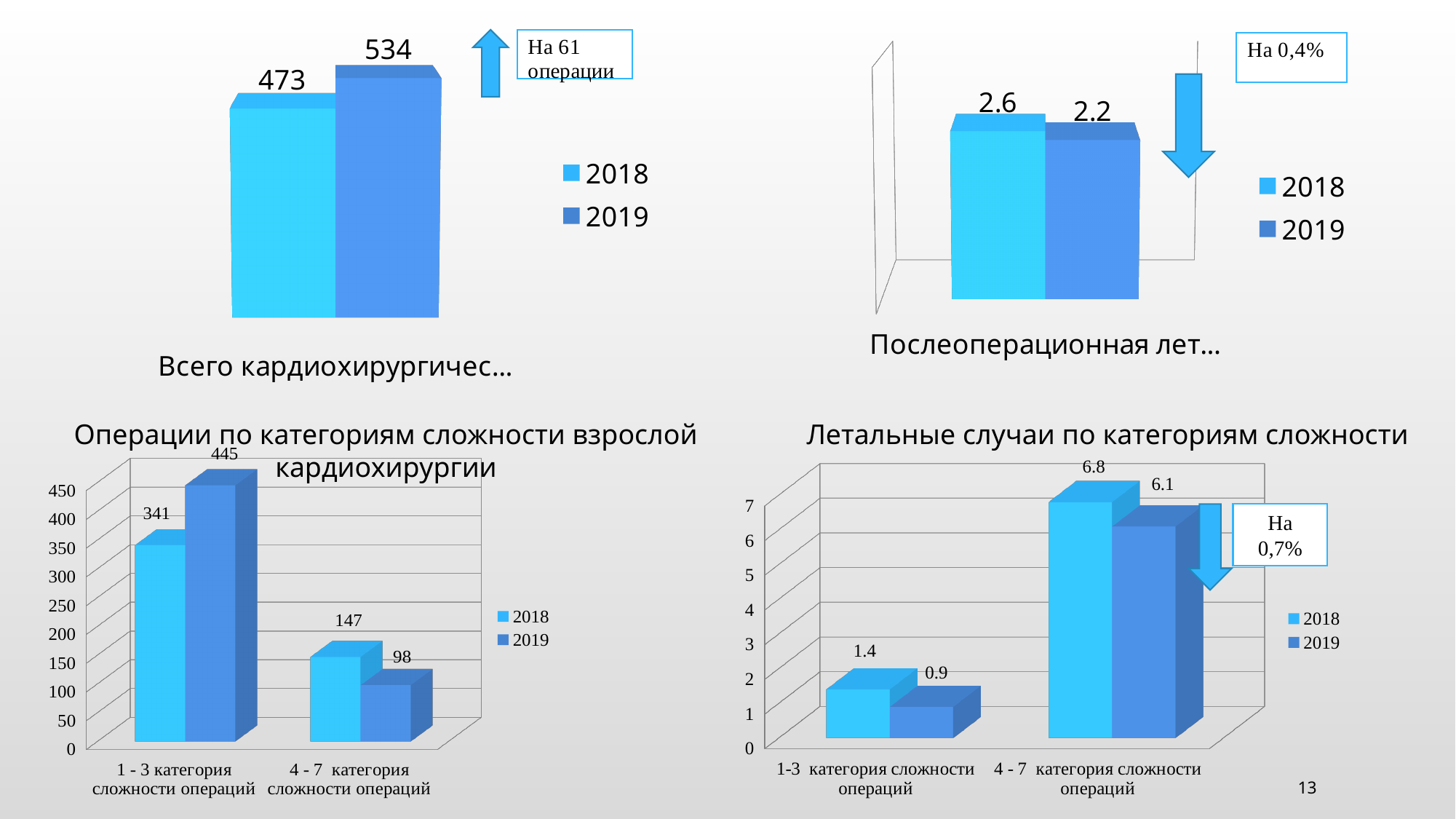
In the bottom-left chart, what is the difference between the 2018 and 2019 values for '4 - 7 категория сложности операций'? 49 In the bottom-left chart, how many categories are shown on the x axis? 2 In the top-left chart, what is the difference between the 2019 and 2018 values? 61 In the bottom-left chart 'Операции по категориям сложности взрослой кардиохирургии', what is the 2019 value for '1 - 3 категория сложности операций'? 445 In the top-right chart, which year has the lower value, 2018 or 2019? 2019 In the bottom-left chart 'Операции по категориям сложности взрослой кардиохирургии', what is the 2018 value for '4 - 7 категория сложности операций'? 147 In the bottom-right chart, which bar is the highest? 2018, 4 - 7 категория сложности операций In the bottom-right chart 'Летальные случаи по категориям сложности', what is the 2019 value for '1-3 категория сложности операций'? 0.9 In the top-right chart (Послеоперационная лет...), what is the value for 2018? 2.6 In the bottom-right chart 'Летальные случаи по категориям сложности', what is the 2018 value for '4 - 7 категория сложности операций'? 6.8 How many series does the legend of the bottom-right chart list? 2 In the top-left chart, what is the value for 2019? 534